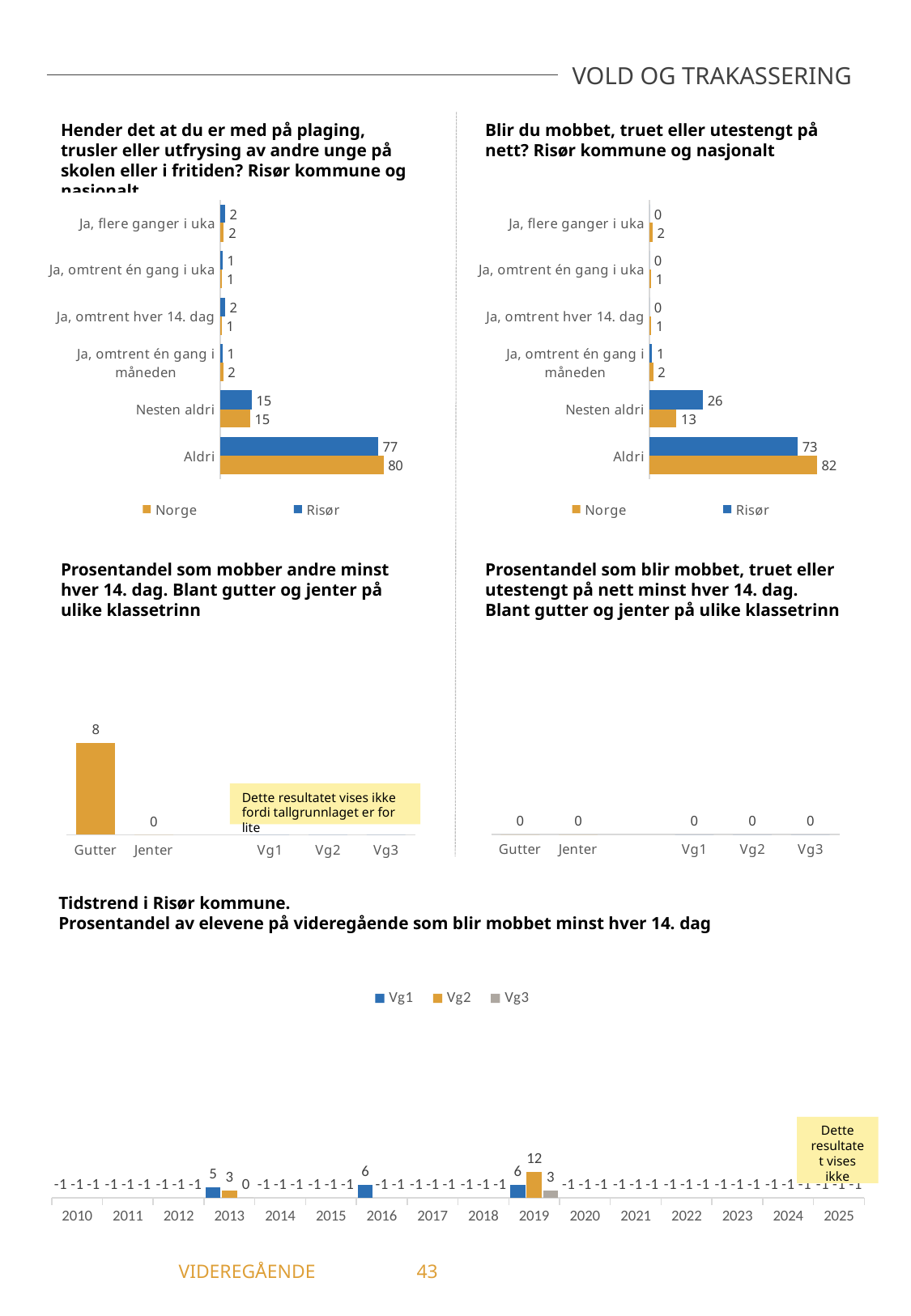
How many series does the legend list in the chart 'Blir du mobbet, truet eller utestengt på nett?'? 2 In the chart 'Blir du mobbet, truet eller utestengt på nett?', what is the value for Risør in the 'Nesten aldri' category? 26 In the chart 'Blir du mobbet, truet eller utestengt på nett?', what is the difference between Norge and Risør for 'Aldri'? 9 In the chart 'Hender det at du er med på plaging, trusler eller utfrysing av andre unge på skolen eller i fritiden?', what is the difference between Norge and Risør for 'Aldri'? 3 In the chart 'Prosentandel som mobber andre minst hver 14. dag', what is the value for Gutter? 8 In the chart 'Blir du mobbet, truet eller utestengt på nett?', which is larger for 'Nesten aldri': Norge or Risør? Risør In the chart 'Hender det at du er med på plaging, trusler eller utfrysing av andre unge på skolen eller i fritiden?', what is the value for Risør in the 'Aldri' category? 77 In the chart 'Blir du mobbet, truet eller utestengt på nett?', which category has the highest value for Norge? Aldri What type of chart is 'Tidstrend i Risør kommune'? Bar chart In the chart 'Hender det at du er med på plaging, trusler eller utfrysing av andre unge på skolen eller i fritiden?', what is the value for Norge in the 'Aldri' category? 80 In the chart 'Prosentandel som mobber andre minst hver 14. dag', what is the value for Jenter? 0 In the chart 'Tidstrend i Risør kommune', what is the value for Vg2 in 2019? 12